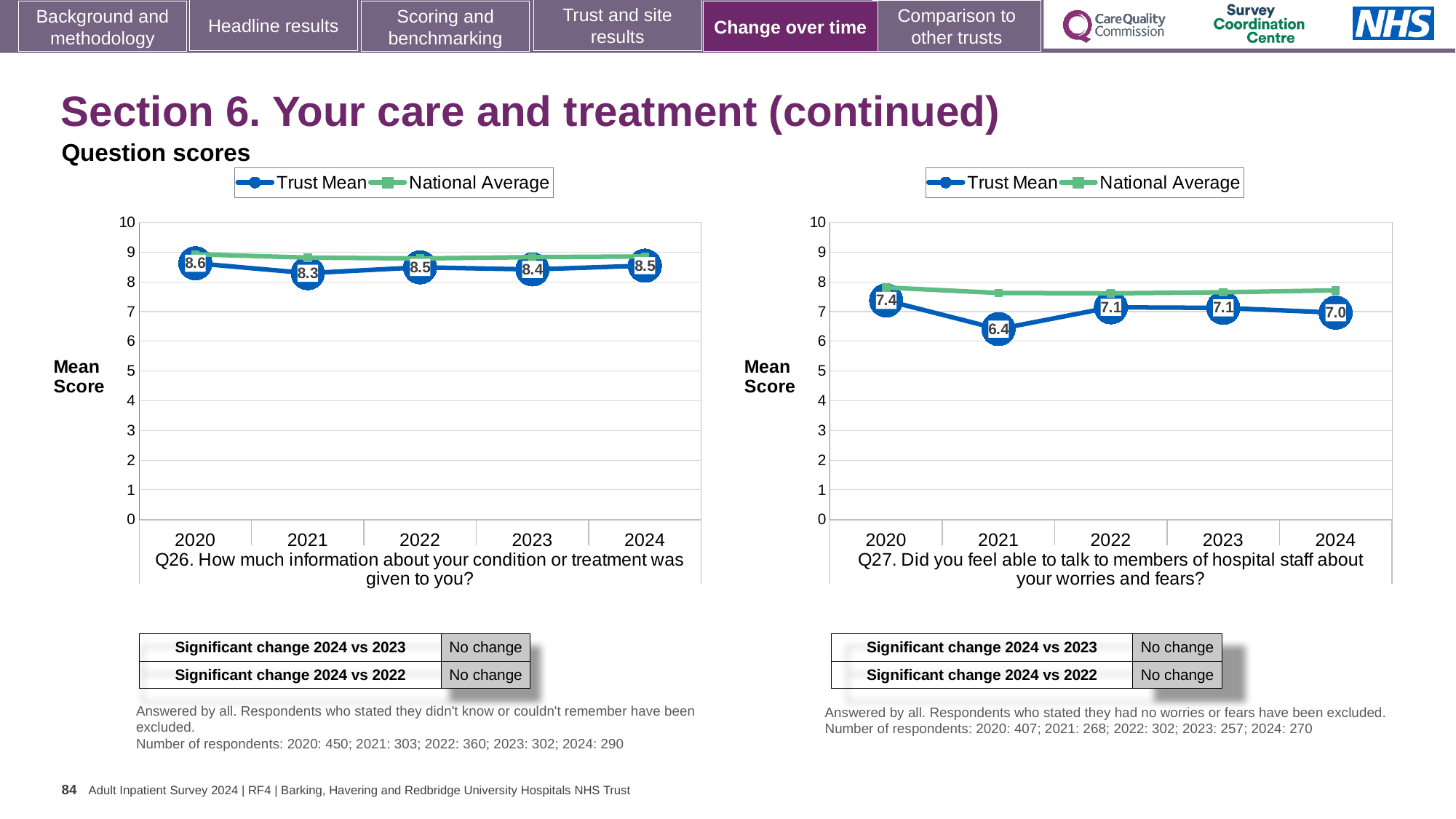
On the Q26 chart, which year has the highest Trust Mean score? 2020 On the Q26 chart, what is the Trust Mean score for 2021? 8.3 What type of chart is used for Q26? Line chart On the Q27 chart, does the Trust Mean rise or fall from 2020 to 2021? Fall On the Q27 chart, is the National Average for 2021 greater or less than 7? greater On the Q27 chart, what is the Trust Mean score for 2024? 7.0 On the Q27 chart, which year has the lowest Trust Mean score? 2021 On the Q26 chart, which is larger, the Trust Mean for 2020 or the Trust Mean for 2021? 2020 On the Q26 chart, is the National Average for 2020 greater or less than 8? greater On the Q27 chart, what is the difference between the Trust Mean scores for 2020 and 2021? 1.0 How many years are plotted on the Q26 chart? 5 How many series does the legend of the Q27 chart list? 2